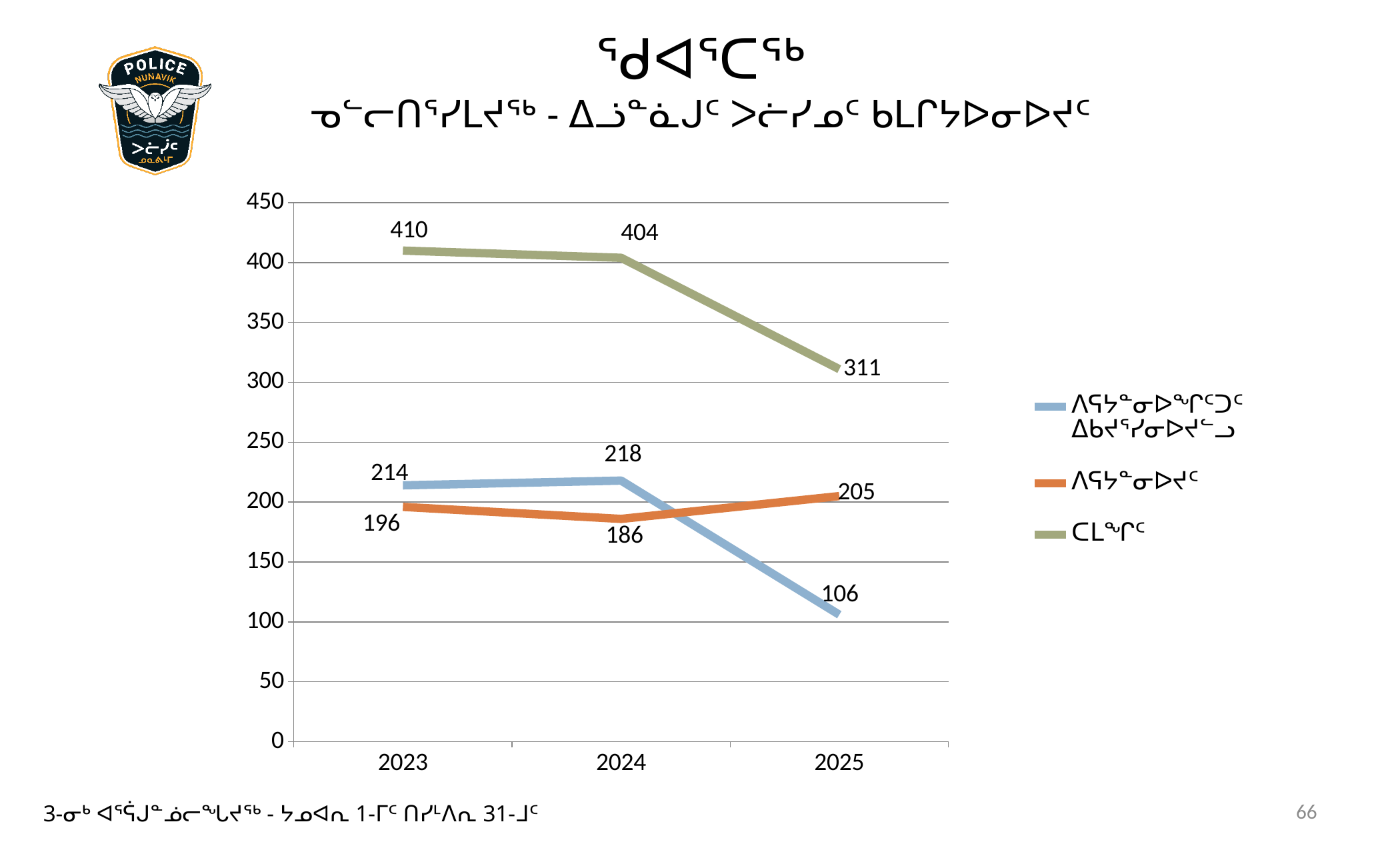
In which year is the orange line at its lowest? 2024 How many series does the legend list? 3 What kind of chart is shown on the slide? line chart Which is larger in 2025, the orange line or the blue line? the orange line How many years are shown on the x axis? 3 What is the difference between the green line's values in 2024 and 2025? 93 What is the value of the green line in 2023? 410 What is the value of the blue line in 2025? 106 What is the value of the green line in 2025? 311 What is the value of the orange line in 2024? 186 In which year is the blue line at its highest? 2024 Does the green line rise or fall from 2023 to 2025? fall